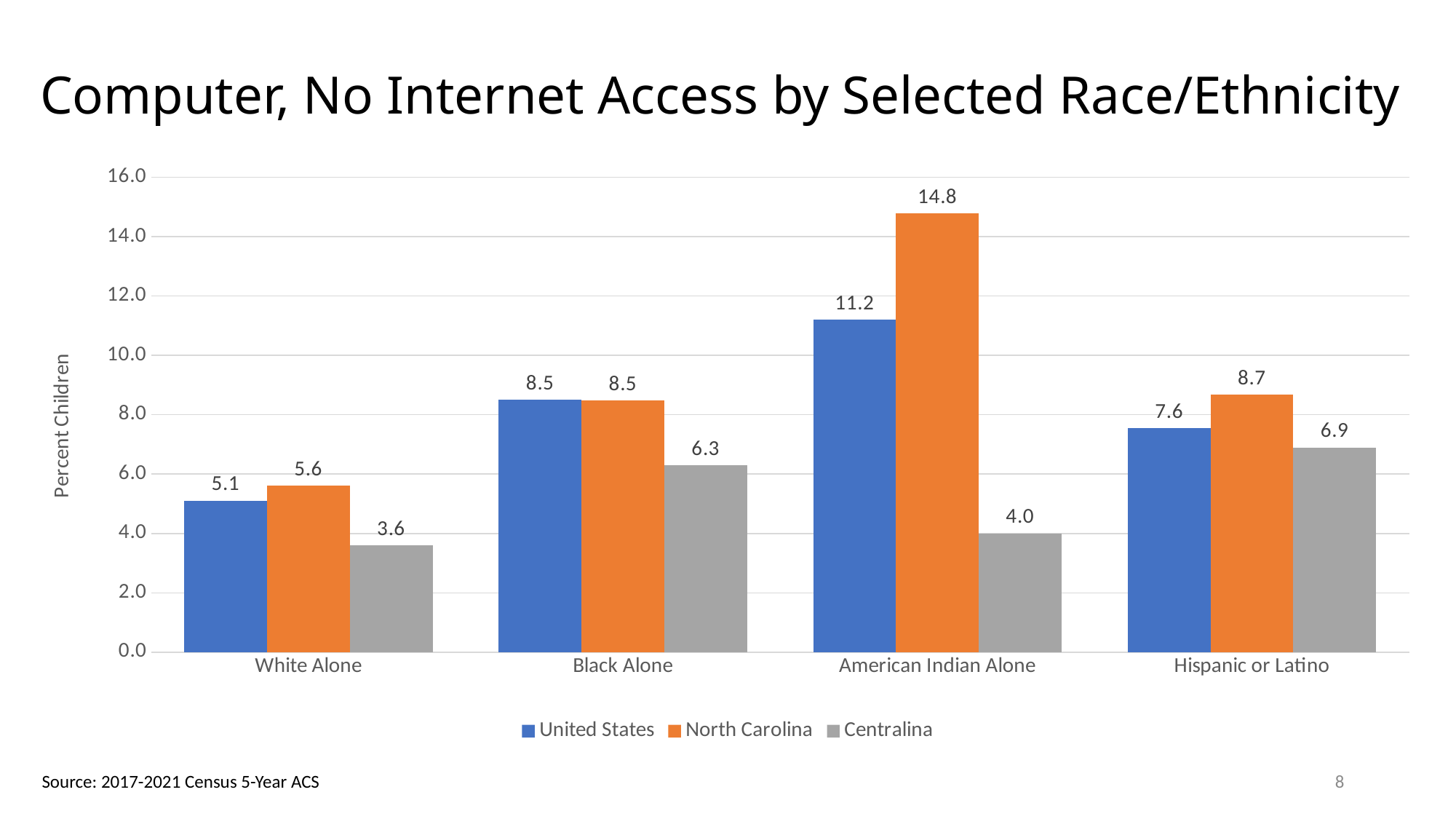
What is the North Carolina value for American Indian Alone? 14.8 How many series does the legend list? 3 What is the label on the vertical axis? Percent Children Which race/ethnicity category has the highest North Carolina value? American Indian Alone Which race/ethnicity category has the lowest Centralina value? White Alone What kind of chart is shown on the slide? Bar chart What is the difference between the North Carolina and Centralina values for American Indian Alone? 10.8 What is the Centralina value for White Alone? 3.6 How many race/ethnicity categories are shown on the x axis? 4 Which is larger for Black Alone: the Centralina value or the United States value? United States What is the title of the chart? Computer, No Internet Access by Selected Race/Ethnicity What is the United States value for Hispanic or Latino? 7.6